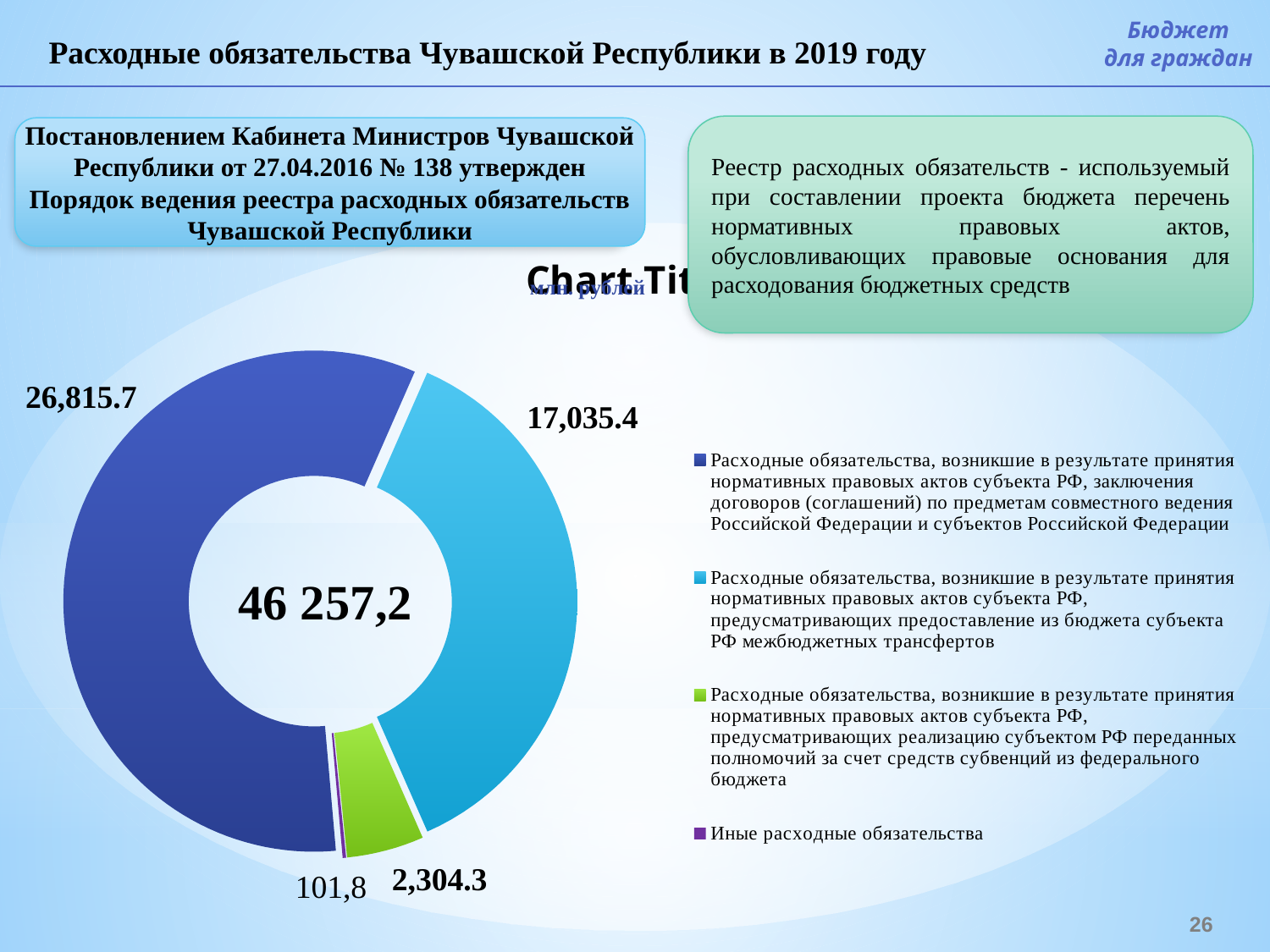
Which is larger: the green slice or the purple slice? the green slice (2,304.3) What is the value of the light blue slice (obligations providing interbudgetary transfers from the regional budget)? 17,035.4 Which legend category has the smallest slice? Иные расходные обязательства What is the value of the largest slice in the doughnut chart? 26,815.7 What is the difference between the dark blue slice (26,815.7) and the light blue slice (17,035.4)? 9,780.3 How many slices does the doughnut chart have? 4 What total is shown in the centre of the doughnut chart? 46 257,2 How many entries does the chart legend list? 4 What kind of chart is shown on the slide? doughnut (pie) chart What is the value of the slice for 'Иные расходные обязательства'? 101,8 In what units are the chart values given, according to the label above the chart? млн рублей What is the value of the green slice (obligations funded by subventions from the federal budget)? 2,304.3